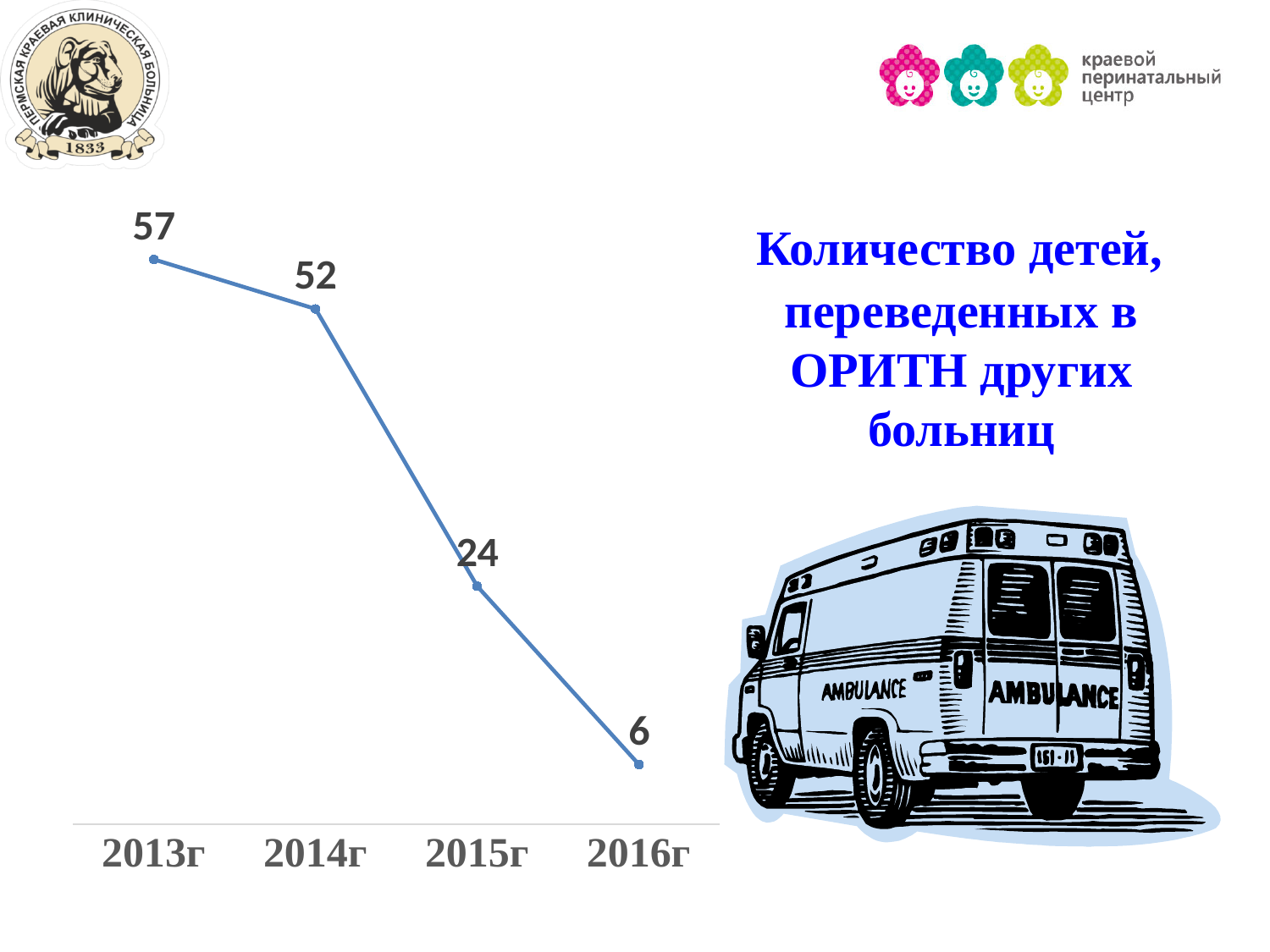
Which year has the highest value? 2013г Which year has the lowest value? 2016г What is the value for 2016г? 6 What is the value for 2014г? 52 What is the value for 2015г? 24 How many data points are plotted on the chart? 4 What kind of chart is shown on the slide? line chart What is the difference between the values for 2013г and 2016г? 51 What is the value for 2013г? 57 Do the values rise or fall from 2013г to 2016г? fall Which is larger, the value for 2014г or the value for 2015г? 2014г What is the difference between the values for 2014г and 2015г? 28